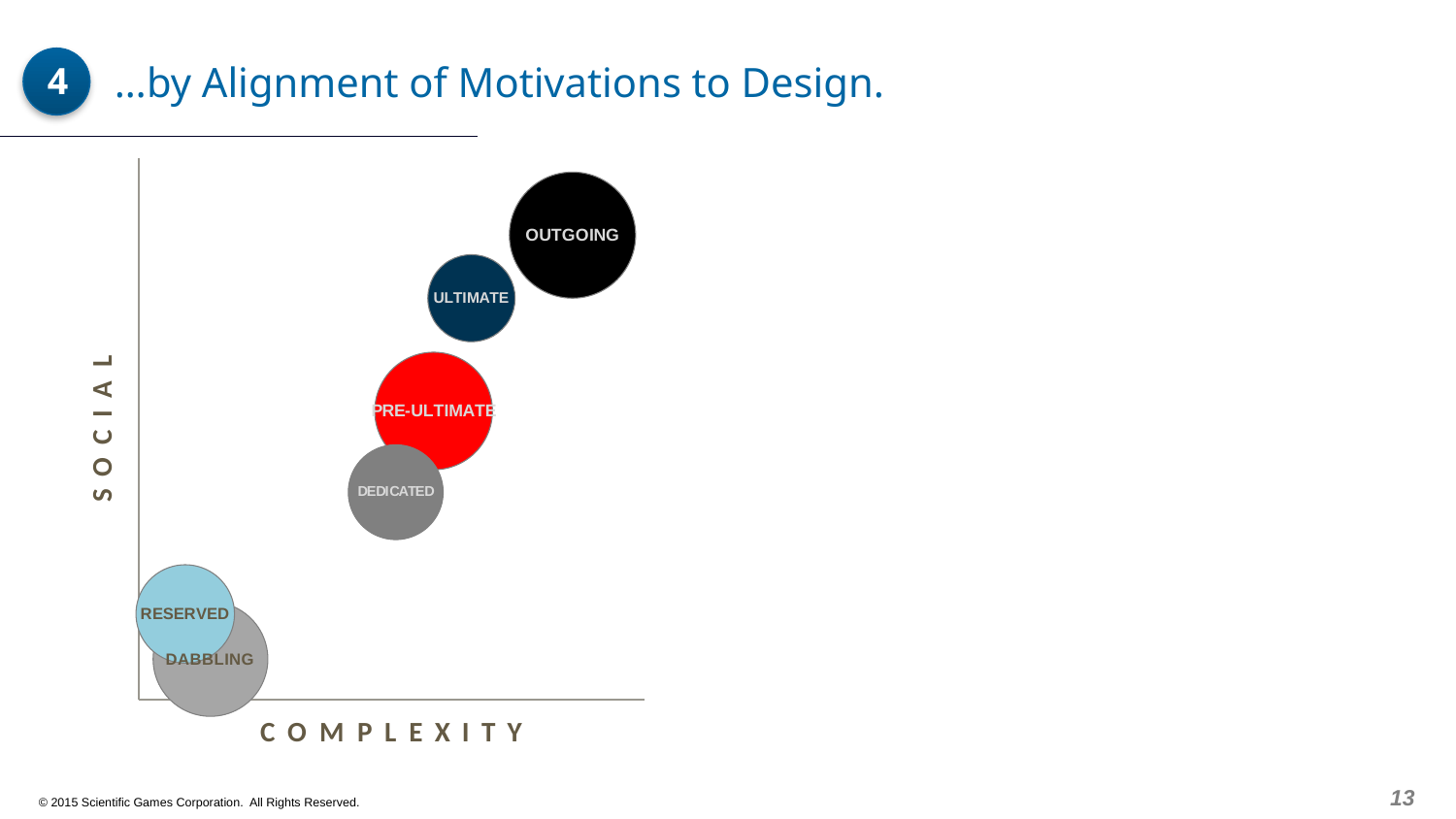
What is the label of the vertical axis of the chart? SOCIAL Which bubble is positioned furthest to the right on the COMPLEXITY axis? OUTGOING As COMPLEXITY increases along the x axis, do the bubbles rise or fall on the SOCIAL axis? Rise Which bubble is positioned highest on the SOCIAL axis? OUTGOING Which bubble is positioned furthest to the left on the COMPLEXITY axis? RESERVED Which bubble is higher on the SOCIAL axis, DEDICATED or PRE-ULTIMATE? PRE-ULTIMATE What is the label of the horizontal axis of the chart? COMPLEXITY How many bubbles are plotted on the chart? 6 Which bubble is the largest on the chart? OUTGOING Which bubble is higher on the SOCIAL axis, ULTIMATE or PRE-ULTIMATE? ULTIMATE Which bubble is positioned lowest on the SOCIAL axis? DABBLING What kind of chart is shown on the slide? Bubble chart